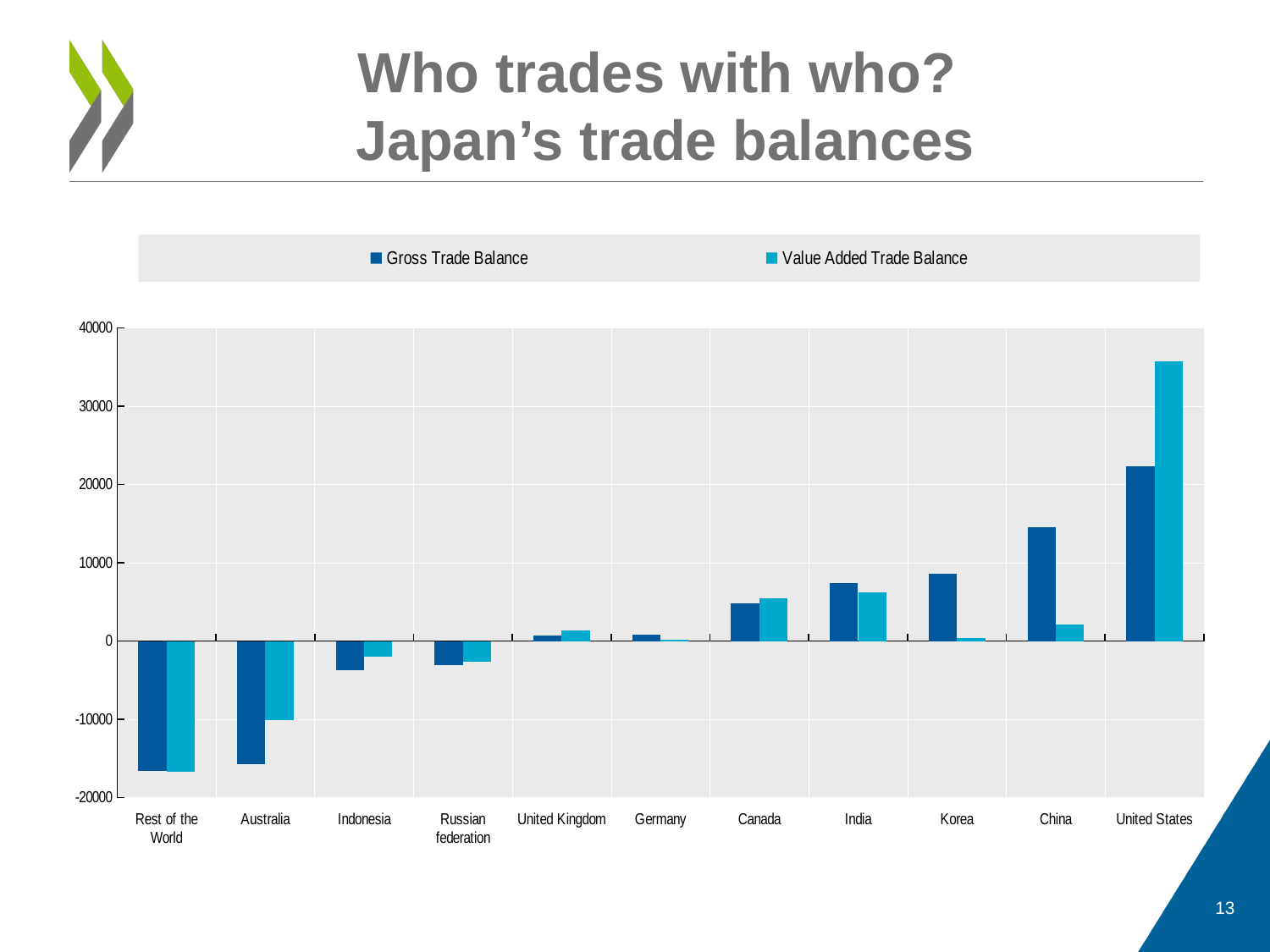
Which country has the highest Value Added Trade Balance? United States Which category has the lowest Value Added Trade Balance? Rest of the World For the United States, which is larger: the Gross Trade Balance or the Value Added Trade Balance? Value Added Trade Balance Is the Value Added Trade Balance for the United States greater or less than 30000? greater How many series does the legend list? 2 Is the Gross Trade Balance for China greater or less than 10000? greater Is the Gross Trade Balance for Australia greater or less than -10000? less Which country has the highest Gross Trade Balance? United States For China, which is larger: the Gross Trade Balance or the Value Added Trade Balance? Gross Trade Balance How many countries or regions are shown on the x axis? 11 What kind of chart is shown on the slide? bar chart What are the two series named in the legend? Gross Trade Balance and Value Added Trade Balance